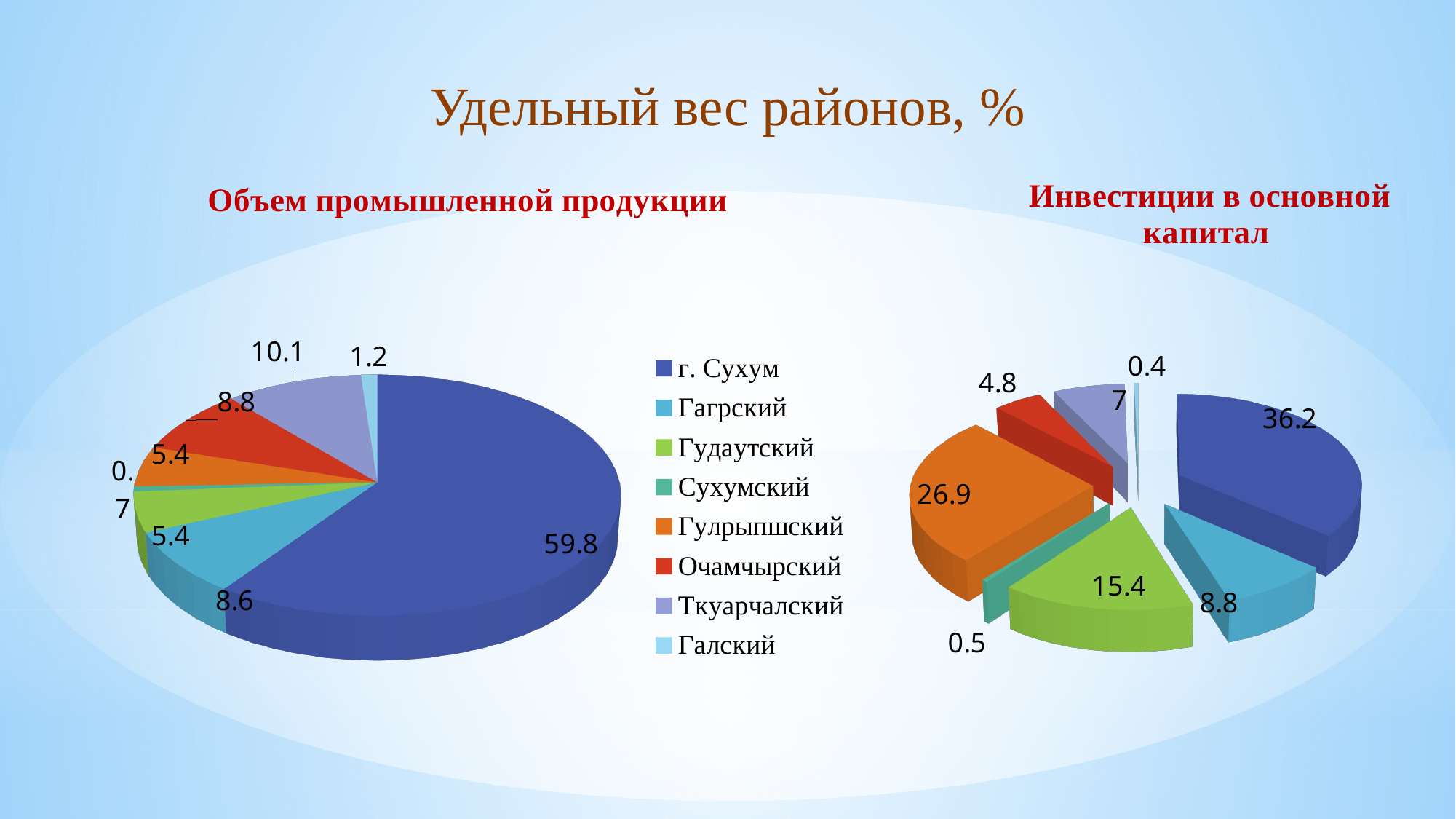
In the 'Объем промышленной продукции' chart, which is larger: Гагрский or Ткуарчалский? Ткуарчалский In the 'Инвестиции в основной капитал' chart, what is the difference between г. Сухум and Гулрыпшский? 9.3 In the 'Инвестиции в основной капитал' chart, what is the value for Гудаутский? 15.4 In the 'Объем промышленной продукции' chart, what is the value for Ткуарчалский? 10.1 In the 'Инвестиции в основной капитал' chart, what is the value for Гулрыпшский? 26.9 In the 'Объем промышленной продукции' chart, what is the value for г. Сухум? 59.8 In the 'Объем промышленной продукции' chart, which district has the largest share? г. Сухум How many districts does the legend list? 8 What type of chart is used on this slide? Pie chart In the 'Инвестиции в основной капитал' chart, which district has the smallest share? Галский In the 'Инвестиции в основной капитал' chart, which district has the largest share? г. Сухум In the 'Объем промышленной продукции' chart, what is the value for Очамчырский? 8.8